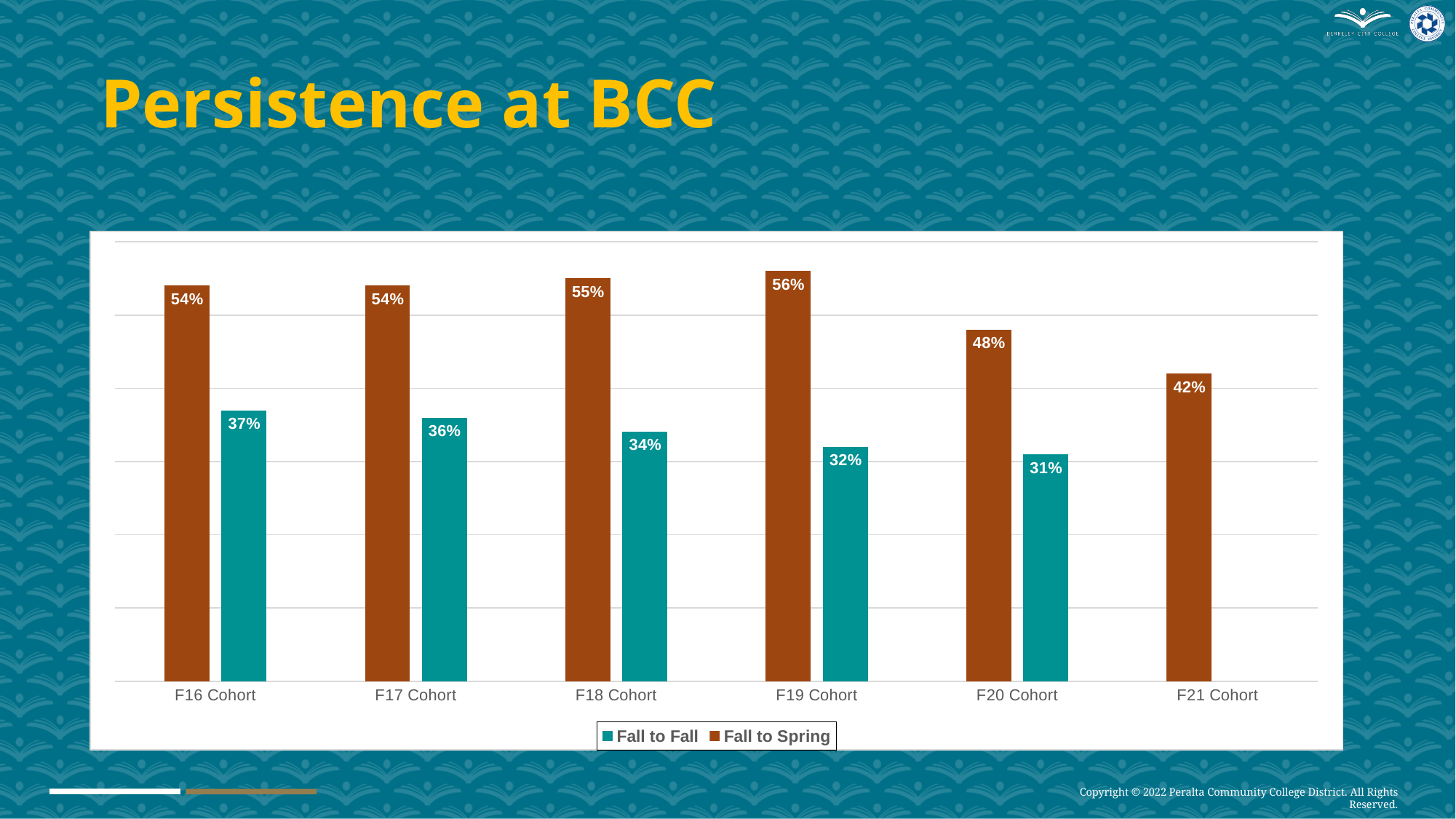
What is the Fall to Fall persistence rate for the F17 Cohort? 36% How many cohorts are shown on the x axis? 6 Which colour represents the Fall to Spring series in the legend? Brown Which cohort has the highest Fall to Spring persistence rate? F19 Cohort How many series does the legend list? 2 What kind of chart is shown on the slide? Bar chart Does the Fall to Fall persistence rate rise or fall from the F16 Cohort to the F20 Cohort? Fall Which cohort has the lowest Fall to Fall persistence rate? F20 Cohort What is the difference between the Fall to Spring and Fall to Fall rates for the F18 Cohort? 21% What is the Fall to Spring persistence rate for the F19 Cohort? 56% Which is larger, the Fall to Fall rate for the F16 Cohort or the Fall to Fall rate for the F19 Cohort? F16 Cohort What is the Fall to Spring persistence rate for the F21 Cohort? 42%